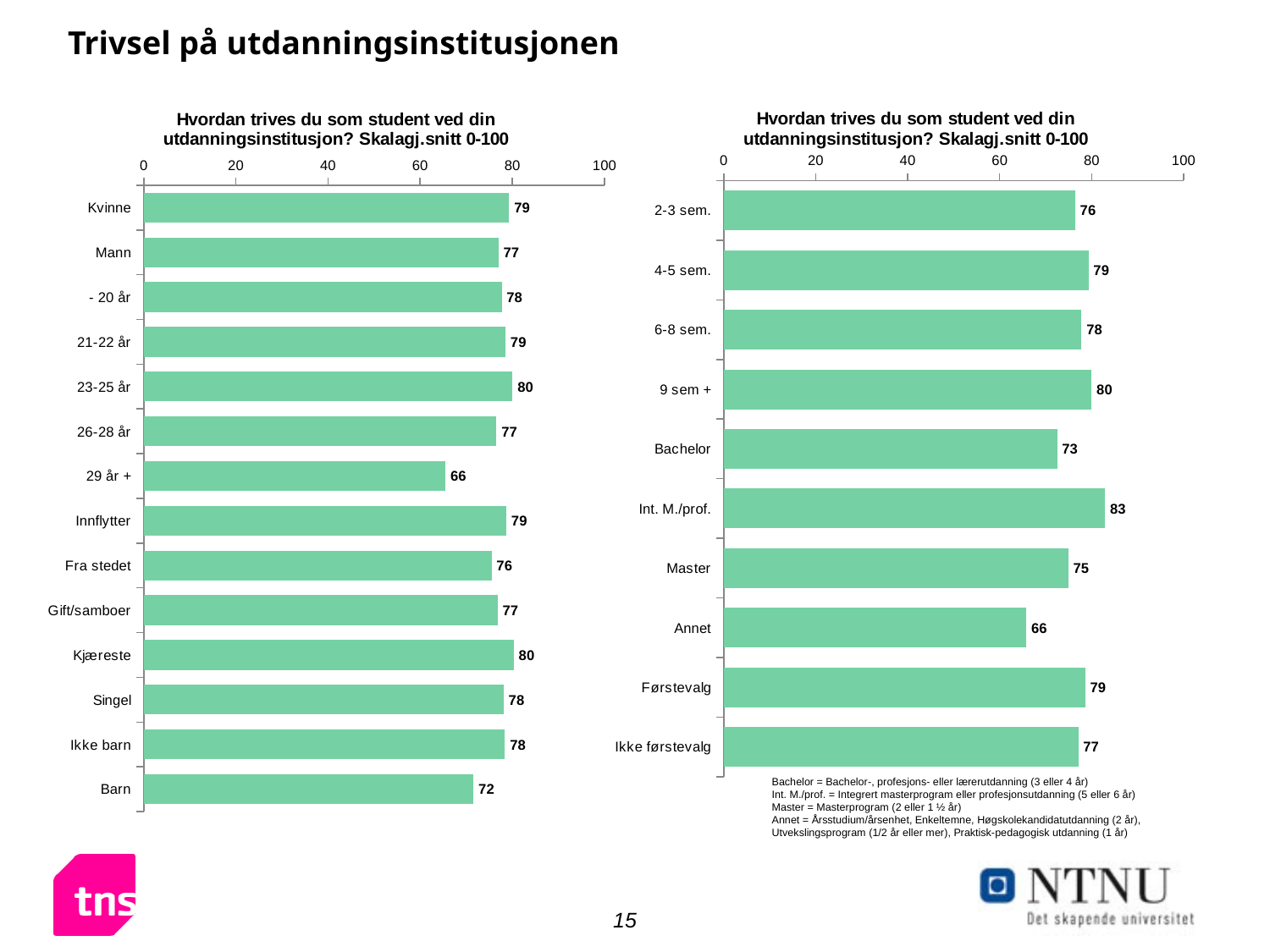
On the right chart, how many categories are shown? 10 On the left chart, how many categories are shown? 14 On the right chart, what is the difference between the values for Int. M./prof. and Master? 8 What type of chart is the left chart? Bar chart On the left chart, which category has the lowest value? 29 år + On the right chart, which is larger, the value for Førstevalg or Ikke førstevalg? Førstevalg On the left chart, what is the difference between the values for Ikke barn and Barn? 6 On the right chart, which category has the highest value? Int. M./prof. On the right chart, which category has the lowest value? Annet On the left chart, what is the value for Barn? 72 On the right chart, what is the value for Bachelor? 73 On the left chart, what is the value for Kvinne? 79